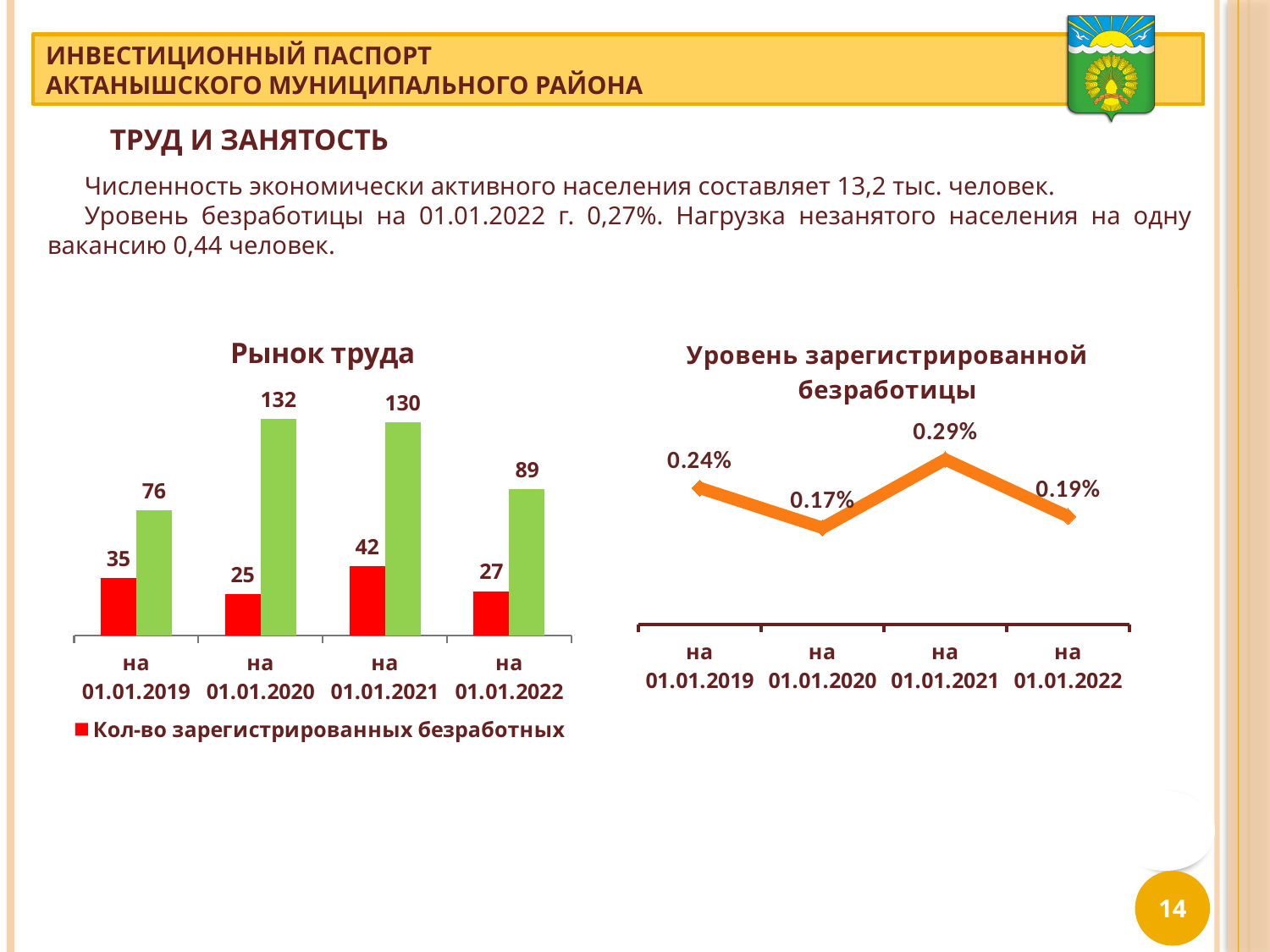
In the 'Уровень зарегистрированной безработицы' chart, what is the value for 'на 01.01.2021'? 0.29% In the 'Уровень зарегистрированной безработицы' chart, which category has the lowest value? на 01.01.2020 In the 'Рынок труда' chart, which category has the highest value for 'Кол-во зарегистрированных безработных'? на 01.01.2021 What kind of chart is 'Уровень зарегистрированной безработицы'? Line chart In the 'Уровень зарегистрированной безработицы' chart, is the value for 'на 01.01.2019' larger or smaller than the value for 'на 01.01.2022'? Larger In the 'Рынок труда' chart, what is the value of 'Кол-во зарегистрированных безработных' for 'на 01.01.2019'? 35 What kind of chart is 'Рынок труда'? Bar chart In the 'Рынок труда' chart, what is the value of 'Кол-во зарегистрированных безработных' for 'на 01.01.2021'? 42 In the 'Рынок труда' chart, which category has the lowest value for 'Кол-во зарегистрированных безработных'? на 01.01.2020 In the 'Рынок труда' chart, what is the value of the green bar for 'на 01.01.2020'? 132 In the 'Рынок труда' chart, what is the difference between the 'Кол-во зарегистрированных безработных' values for 'на 01.01.2021' and 'на 01.01.2022'? 15 In the 'Рынок труда' chart, how many categories are shown on the x axis? 4